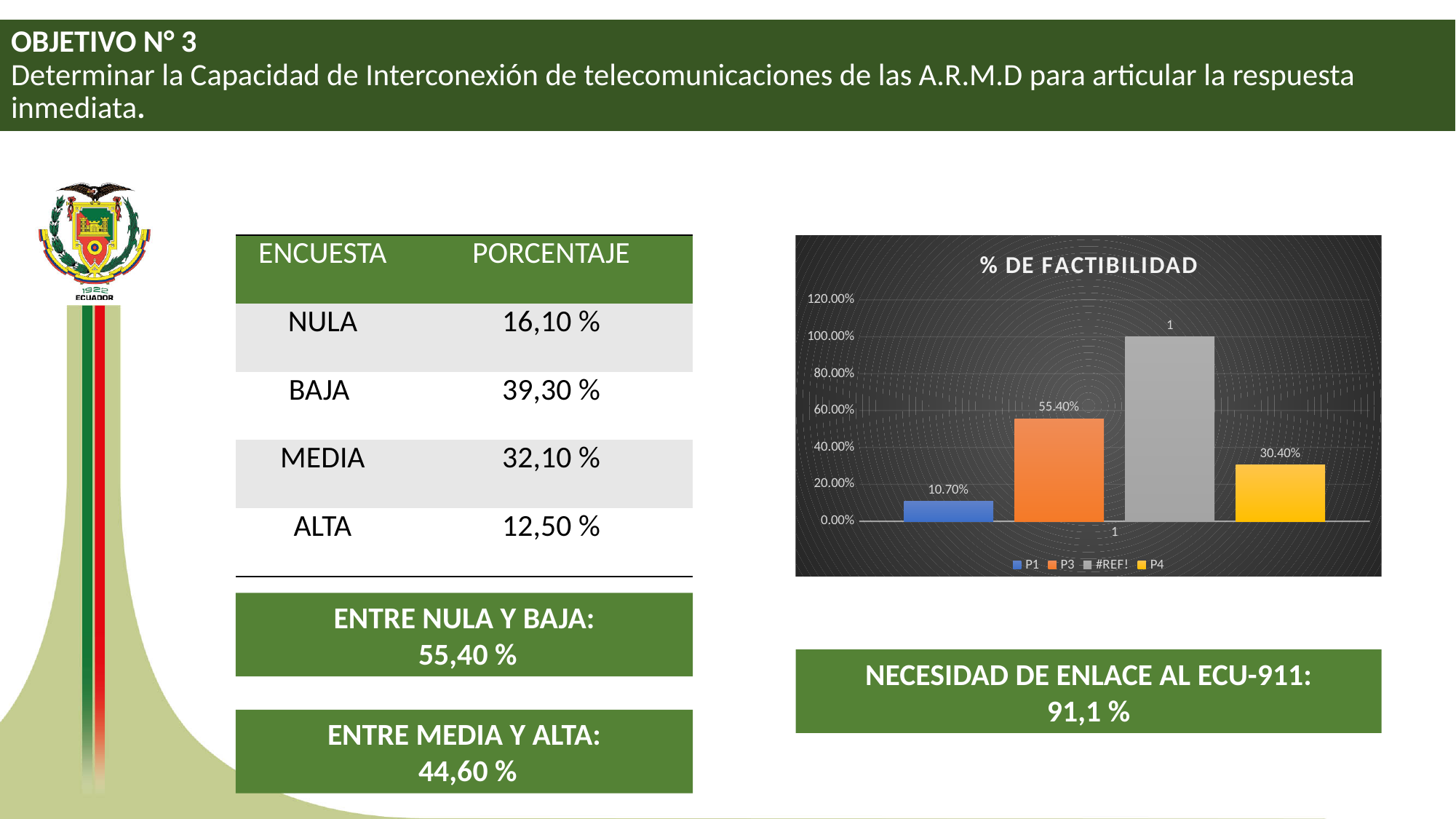
What is the value of the P1 bar in the chart? 10.70% What is the value of the P3 bar in the chart? 55.40% What data label is shown on the #REF! bar in the chart? 1 What is the title of the chart? % DE FACTIBILIDAD What is the difference between the P3 and P4 values in the chart? 25.00% What type of chart is shown on the slide? bar chart Is the value for P3 greater or less than 40.00%? greater What is the value of the P4 bar in the chart? 30.40% Which series has the lowest value in the chart? P1 How many series does the chart legend list? 4 Which is larger in the chart, the P1 value or the P4 value? P4 Which series has the highest bar in the chart? #REF!